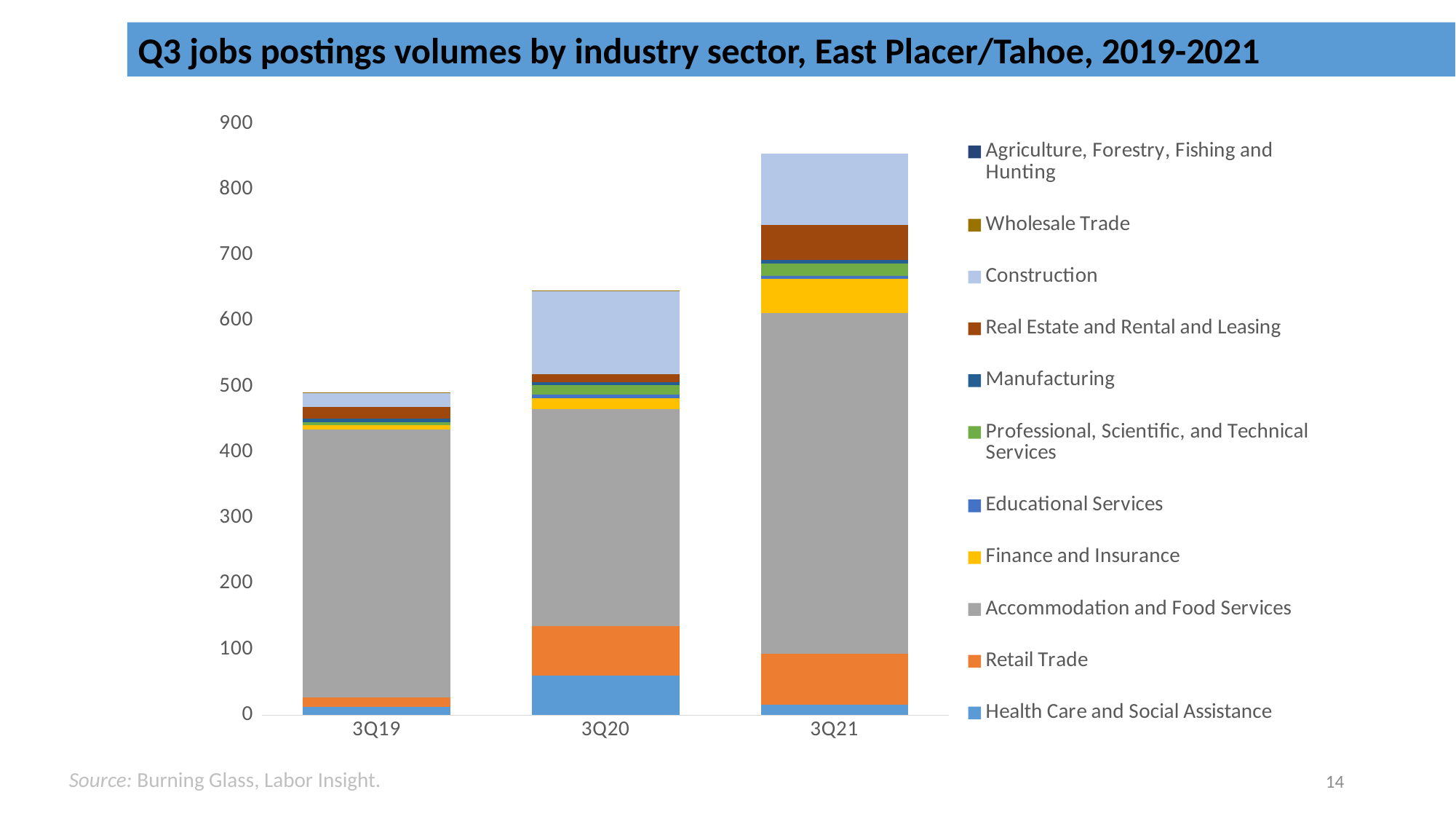
Is the total job postings volume for 3Q20 greater or less than 600? greater Is the Health Care and Social Assistance segment larger in 3Q20 or 3Q21? 3Q20 Which quarter has the highest total job postings volume? 3Q21 Is the Retail Trade segment larger in 3Q19 or 3Q20? 3Q20 How many quarters (bars) are shown on the x axis? 3 Is the total job postings volume for 3Q21 greater or less than 800? greater Do total job postings rise or fall from 3Q19 to 3Q21? Rise How many industry sectors does the legend list? 11 Which quarter has the lowest total job postings volume? 3Q19 Which industry sector makes up the largest segment of each bar? Accommodation and Food Services What kind of chart is shown on the slide? Stacked bar chart